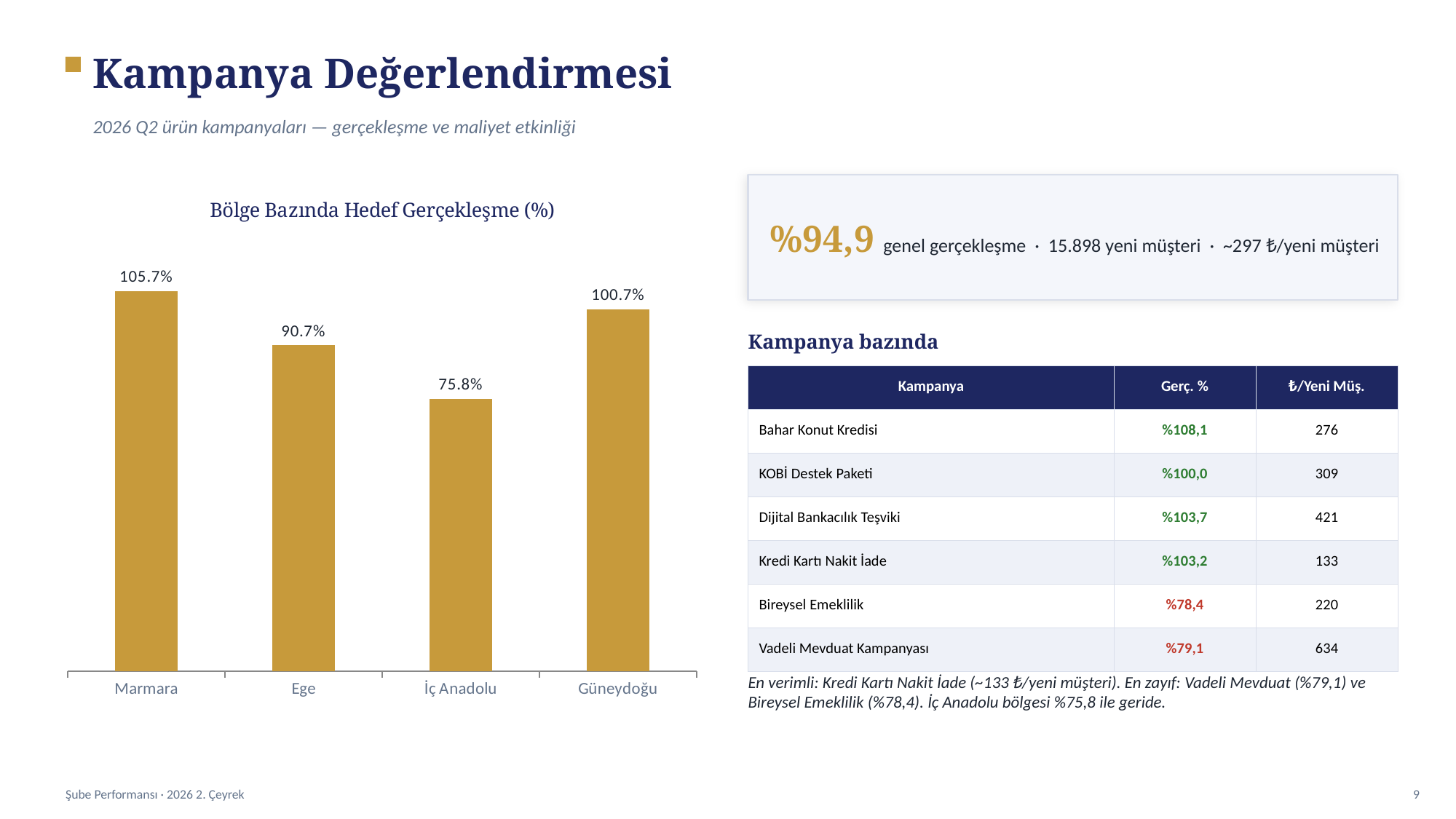
Do the values rise or fall from Marmara to İç Anadolu along the x axis? Fall How many regions are shown in the bar chart? 4 What is the value for Marmara in the Bölge Bazında Hedef Gerçekleşme (%) chart? 105.7% What is the title of the chart on the slide? Bölge Bazında Hedef Gerçekleşme (%) Which is larger, the value for Ege or the value for Güneydoğu? Güneydoğu What kind of chart is used to show target achievement by region? Bar chart Which region has the highest target achievement in the chart? Marmara Which region has the lowest target achievement in the chart? İç Anadolu What is the value for İç Anadolu in the bar chart? 75.8% What is the value for Güneydoğu in the bar chart? 100.7% What is the difference between the values for Marmara and İç Anadolu? 29.9 percentage points What is the value for Ege in the bar chart? 90.7%